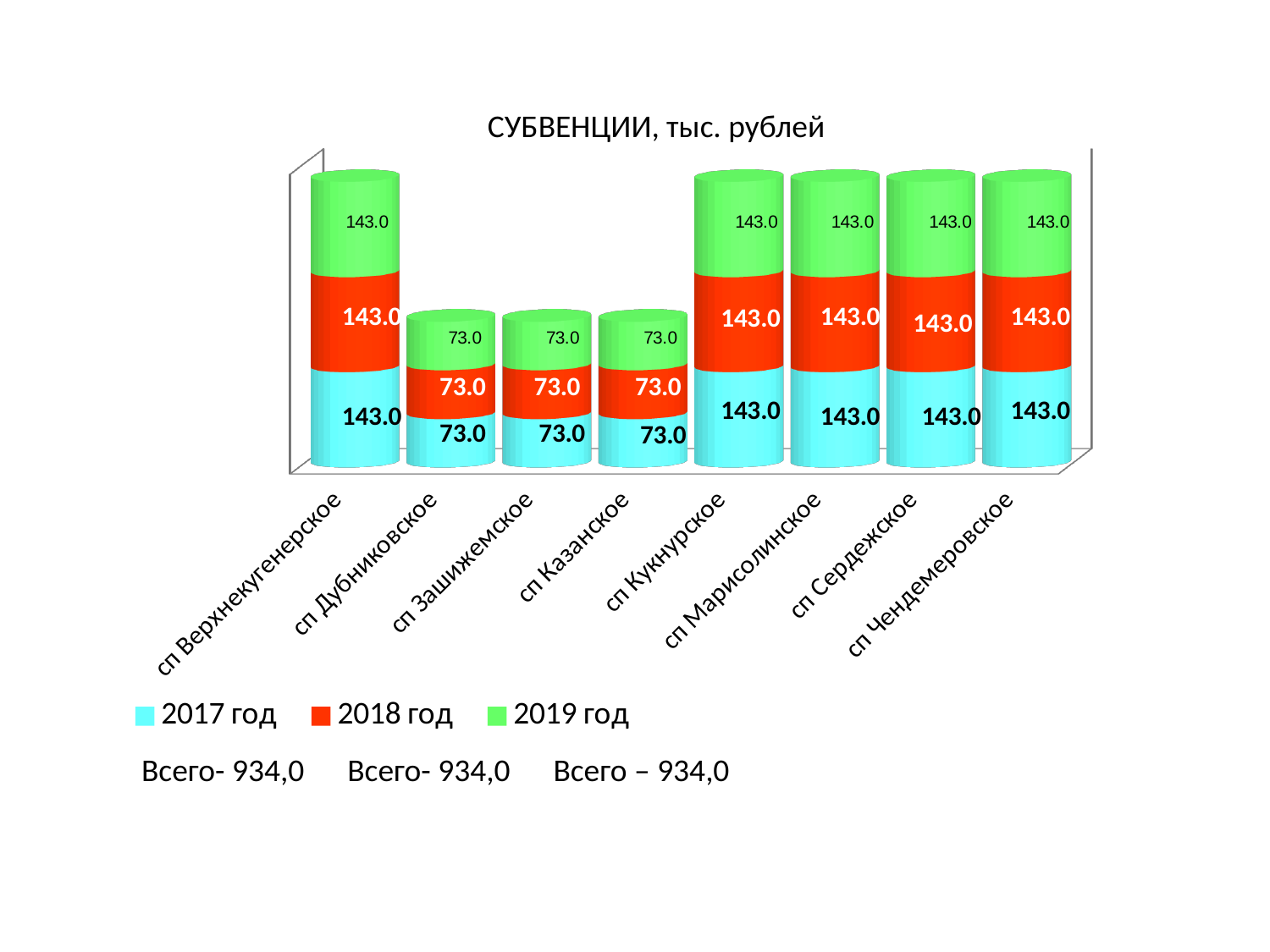
Which series is shown in green in the legend? 2019 год What is the total of the stacked bar for сп Сердежское? 429.0 Which is larger, the 2019 год value for сп Марисолинское or for сп Казанское? сп Марисолинское What is the title of the chart? СУБВЕНЦИИ, тыс. рублей How many series does the legend list? 3 What is the difference between the 2017 год values for сп Верхнекугенерское and сп Дубниковское? 70.0 What is the value for сп Кукнурское in the 2019 год series? 143.0 What is the value for сп Казанское in the 2017 год series? 73.0 How many categories are shown on the x axis? 8 What kind of chart is shown on the slide? stacked bar chart What is the total of the stacked bar for сп Зашижемское? 219.0 What is the value for сп Дубниковское in the 2018 год series? 73.0